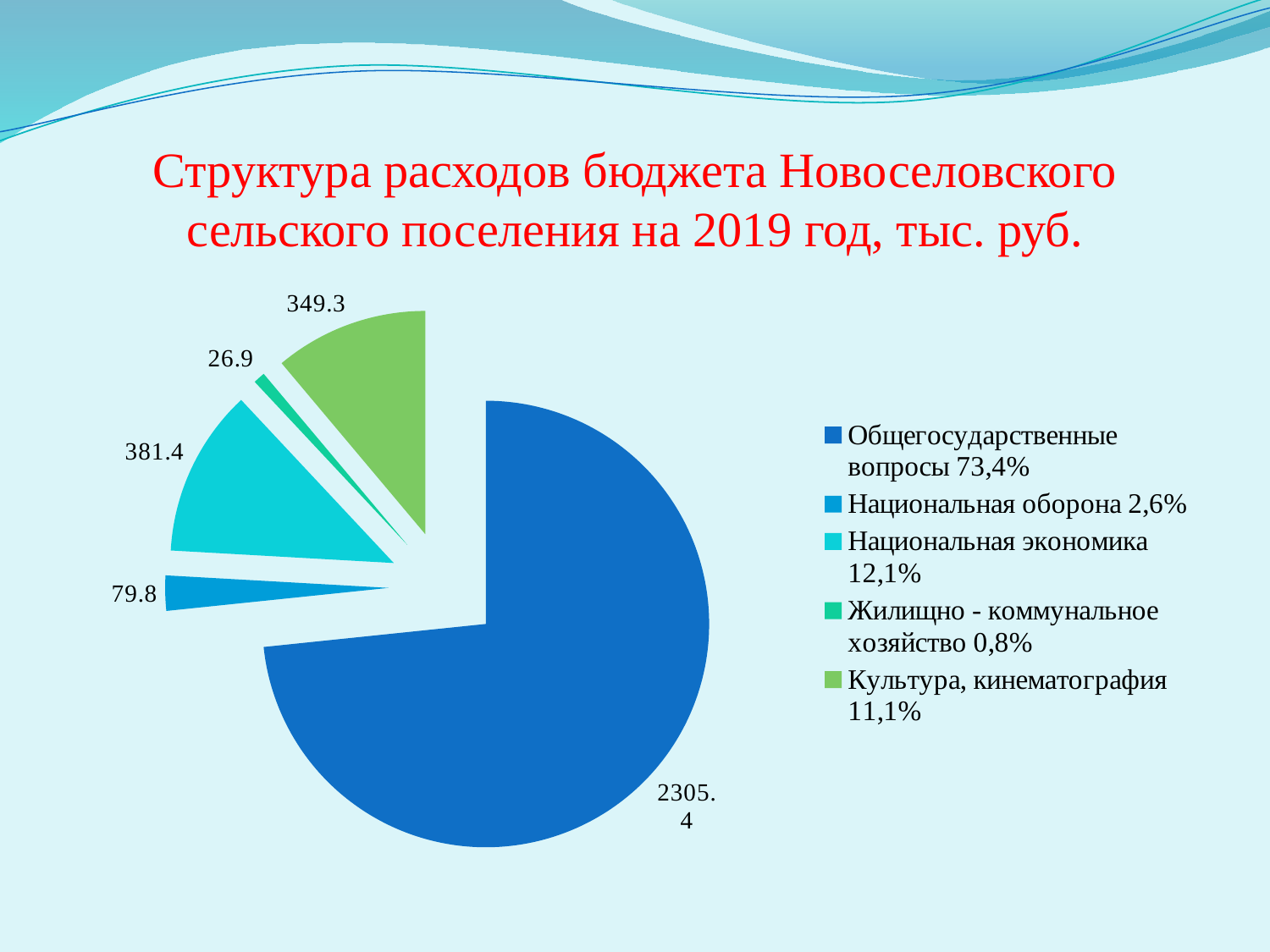
Which category has the smallest slice of the pie? Жилищно - коммунальное хозяйство Which is larger, the value for Национальная оборона or the value for Жилищно - коммунальное хозяйство? Национальная оборона What is the value for Национальная экономика? 381.4 How many slices does the pie chart have? 5 What type of chart is shown on the slide? Pie chart What is the title of the chart? Структура расходов бюджета Новоселовского сельского поселения на 2019 год, тыс. руб. What is the difference between the values for Национальная экономика and Культура, кинематография? 32.1 What is the value for Жилищно - коммунальное хозяйство? 26.9 What is the value for Общегосударственные вопросы? 2305.4 What is the value for Национальная оборона? 79.8 What share of the pie does Культура, кинематография represent? 11,1% Which category has the largest slice of the pie? Общегосударственные вопросы